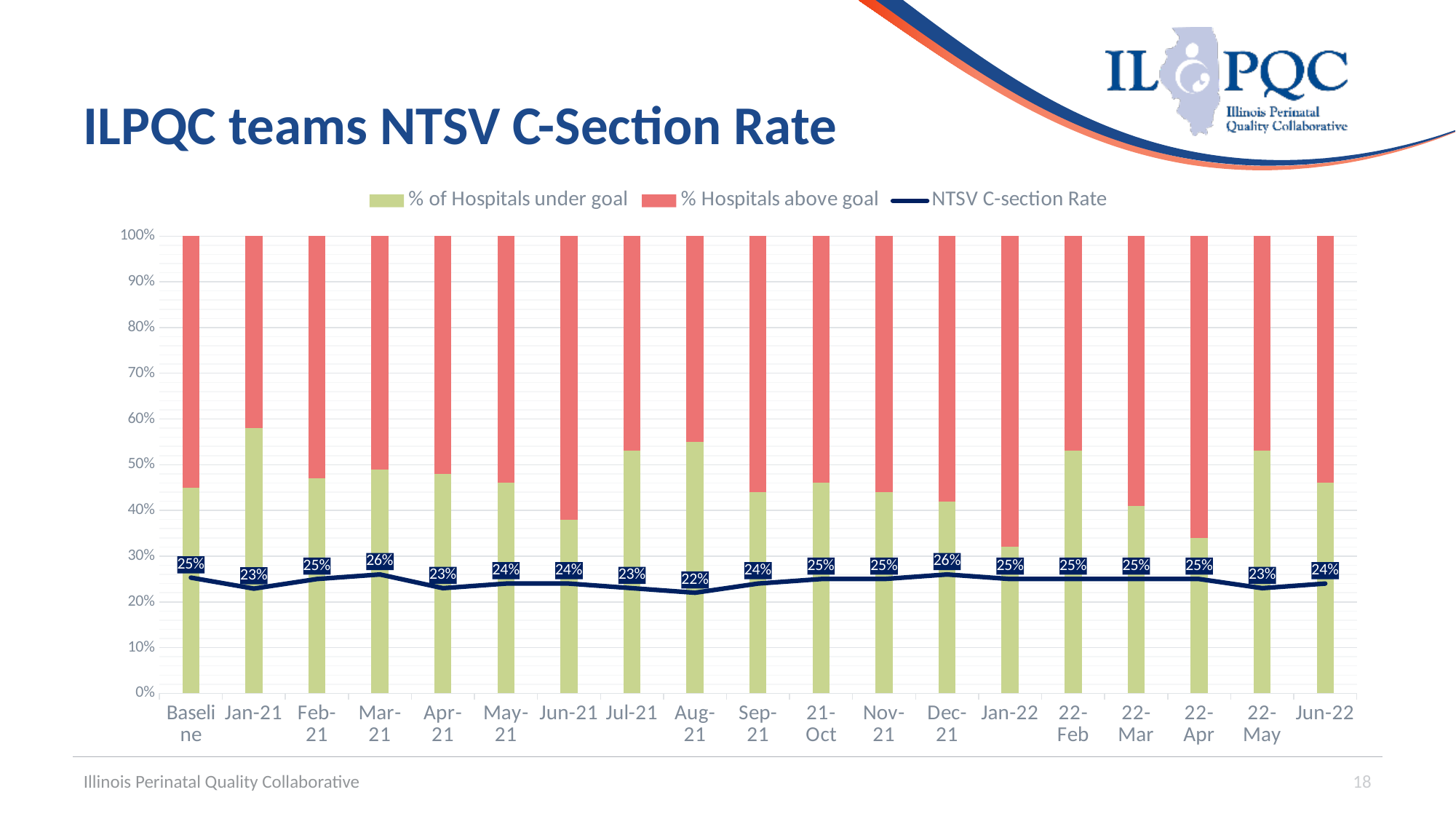
Is the % of Hospitals under goal for Jan-22 greater or less than 40%? less What is the NTSV C-section Rate at Baseline? 25% Which period has the lowest NTSV C-section Rate? Aug-21 What is the NTSV C-section Rate for Aug-21? 22% How many series does the legend list? 3 What is the NTSV C-section Rate for Dec-21? 26% How many periods are shown on the x axis? 19 What kind of chart is this? Stacked bar chart with a line Is the % of Hospitals under goal for Jan-21 greater or less than 50%? greater What is the title of the chart? ILPQC teams NTSV C-Section Rate What is the difference between the NTSV C-section Rate in Mar-21 and in Aug-21? 4 percentage points Which is higher, the NTSV C-section Rate in Dec-21 or in Jan-21? Dec-21